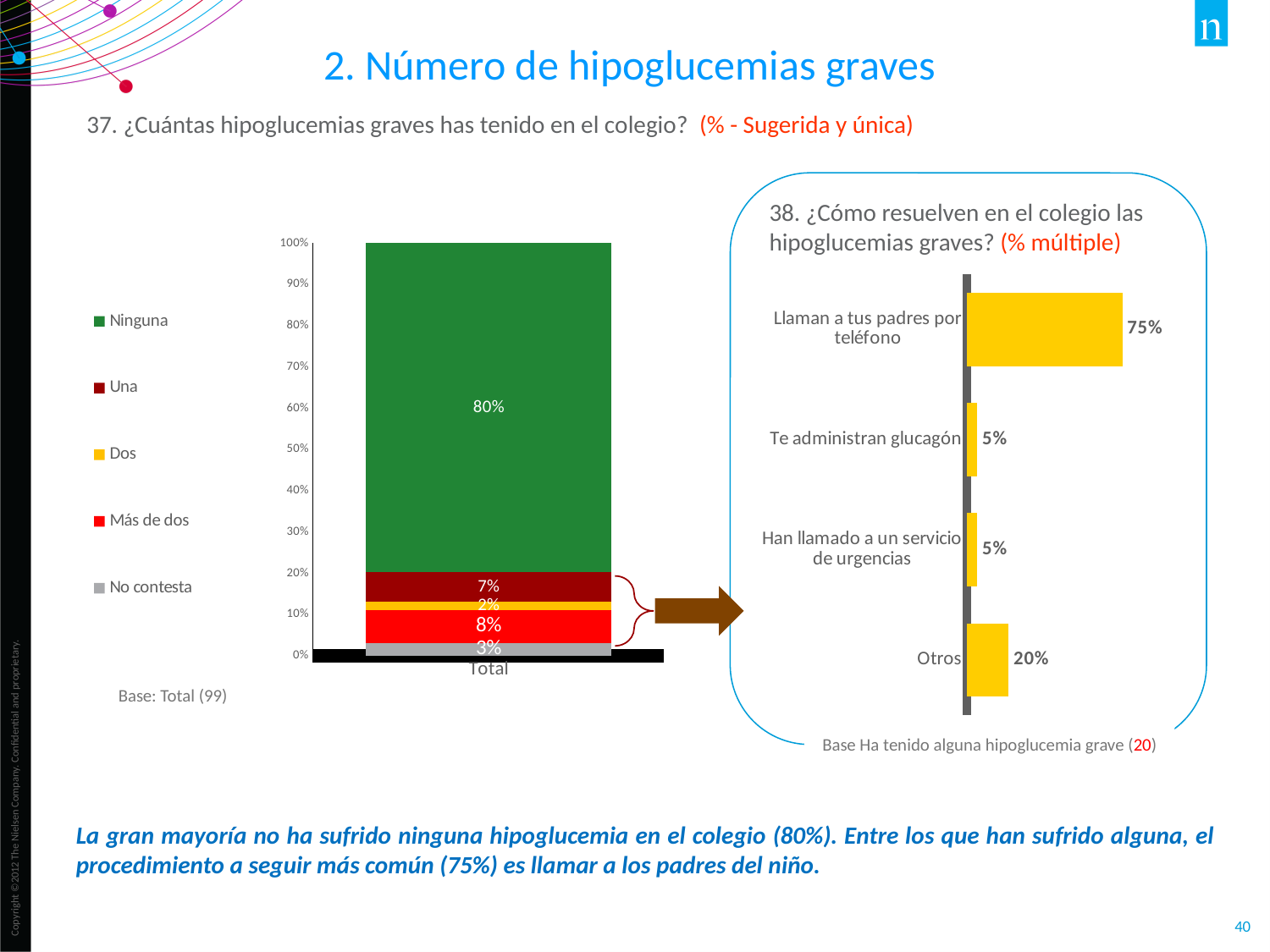
In the chart on the right (question 38), which category has the highest value? Llaman a tus padres por teléfono In the stacked bar chart on the left, how many series does the legend list? 5 In the chart on the right (question 38), what is the difference between 'Llaman a tus padres por teléfono' and 'Otros'? 55% In the chart on the right (question 38), what percentage is shown for 'Otros'? 20% In the stacked bar chart on the left, what percentage is shown for 'Ninguna'? 80% In the stacked bar chart on the left, which category has the smallest share? Dos What type of chart is the chart on the right (question 38)? Bar chart In the chart on the right (question 38), how many categories are plotted? 4 In the chart on the right (question 38), what percentage is shown for 'Llaman a tus padres por teléfono'? 75% In the stacked bar chart on the left, what is the difference between the 'Ninguna' and 'Una' percentages? 73% In the stacked bar chart on the left, what percentage is shown for 'Más de dos'? 8% In the stacked bar chart on the left, what percentage is shown for 'Una'? 7%